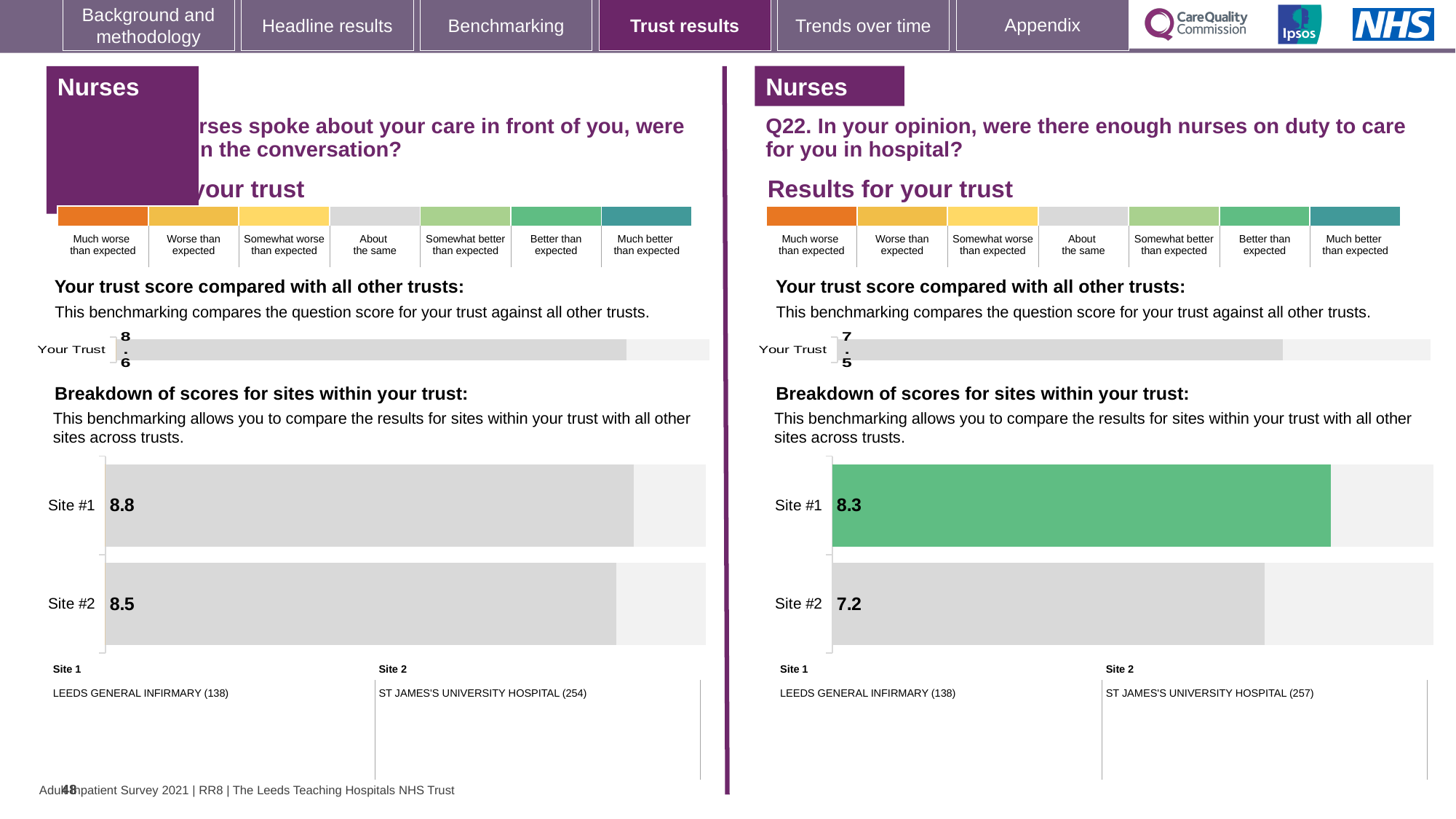
On the left-hand site breakdown chart, what is the difference between the Site #1 and Site #2 scores? 0.3 On the left-hand site breakdown chart, which site has the lower score? Site #2 On the right-hand chart (Q22), what is the difference between the Site #1 and Site #2 scores? 1.1 On the left-hand side, what is the 'Your Trust' score shown in the trust benchmarking bar? 8.6 On the right-hand chart (Q22), what is the score for Site #2? 7.2 On the right-hand chart (Q22), what is the score for Site #1? 8.3 On the right-hand chart (Q22), which site has the higher score? Site #1 On the right-hand side (Q22), what is the 'Your Trust' score shown in the trust benchmarking bar? 7.5 On the left-hand site breakdown chart, what is the score for Site #1? 8.8 On the left-hand site breakdown chart, what is the score for Site #2? 8.5 How many sites are shown in the right-hand (Q22) site breakdown chart? 2 What type of chart is used for the site breakdown on the right-hand side (Q22)? Bar chart